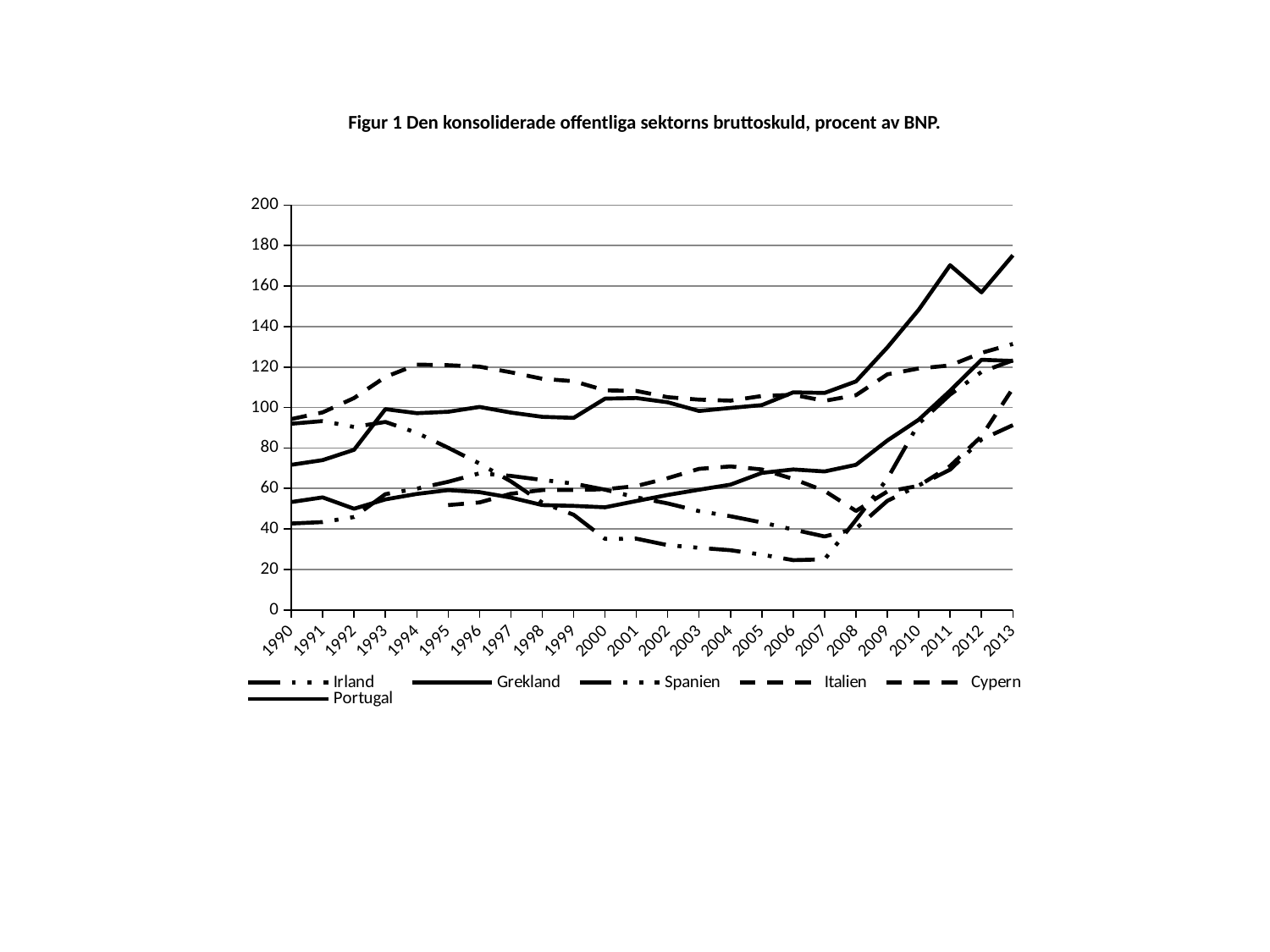
Does the value for Portugal rise or fall between 2008 and 2013? rise What is the title of the chart? Figur 1 Den konsoliderade offentliga sektorns bruttoskuld, procent av BNP. Is the value for Grekland in 2011 greater or less than 160? greater How many years are shown along the x axis? 24 Does the value for Grekland rise or fall between 2008 and 2011? rise Which is larger in 2013, the value for Grekland or the value for Portugal? Grekland Is the value for Portugal in 1990 greater or less than 60? less What kind of chart is shown on the slide? line chart Which series has the highest value in 2013? Grekland Is the value for Portugal in 2013 greater or less than 100? greater How many series does the legend list? 6